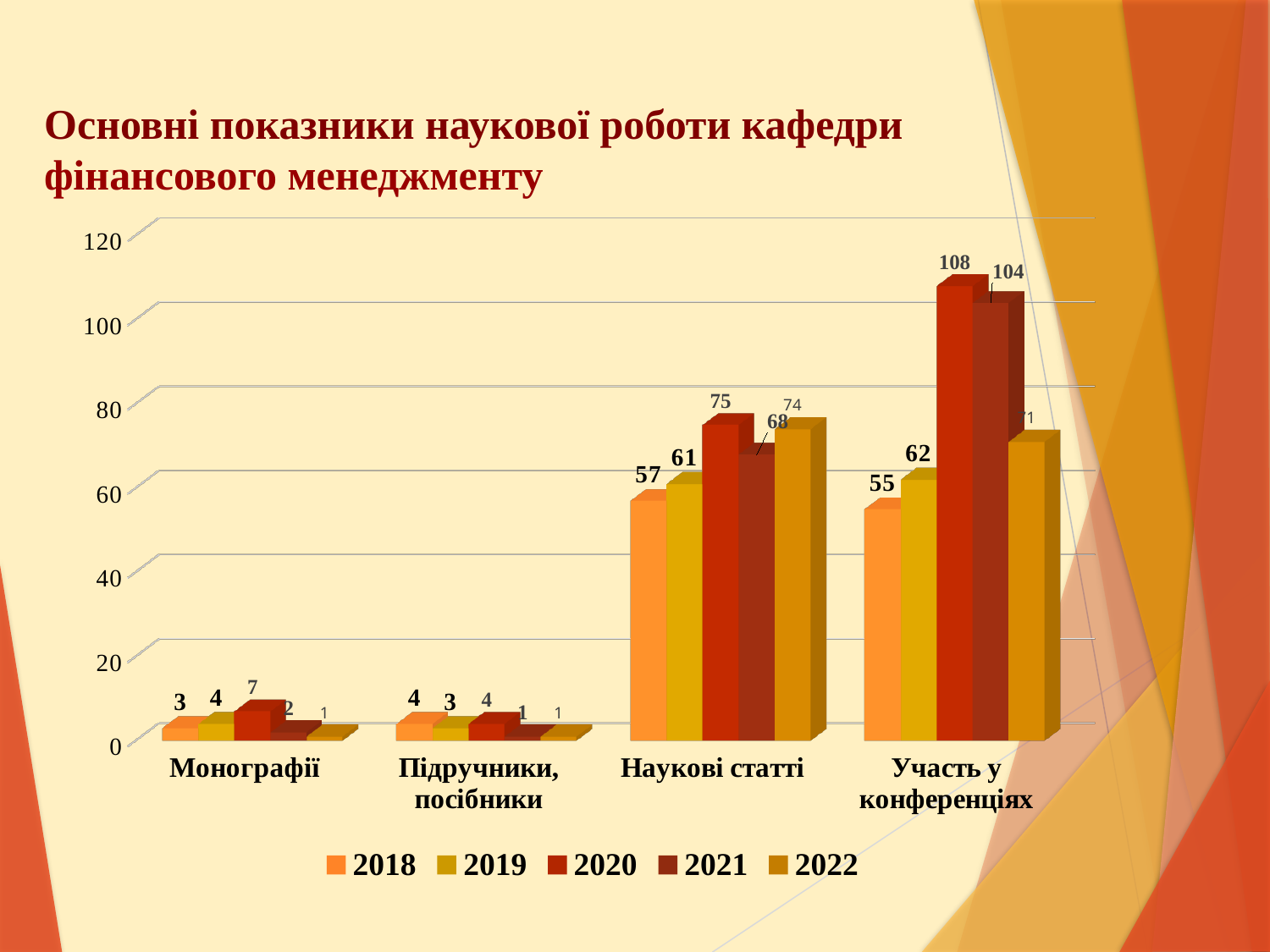
What is the value for 2018 in the Монографії category? 3 Which year has the lowest value in the Наукові статті category? 2018 How many series does the legend list? 5 What is the difference between the 2020 and 2018 values in the Участь у конференціях category? 53 What kind of chart is shown on the slide? bar chart Is the value for 2022 in the Участь у конференціях category greater or less than 80? less What is the value for 2021 in the Участь у конференціях category? 104 How many categories are shown on the x axis of the chart? 4 In the Наукові статті category, which is larger: the value for 2019 or the value for 2021? 2021 What is the value for 2020 in the Наукові статті category? 75 What is the value for 2020 in the Монографії category? 7 Which year has the highest value in the Участь у конференціях category? 2020